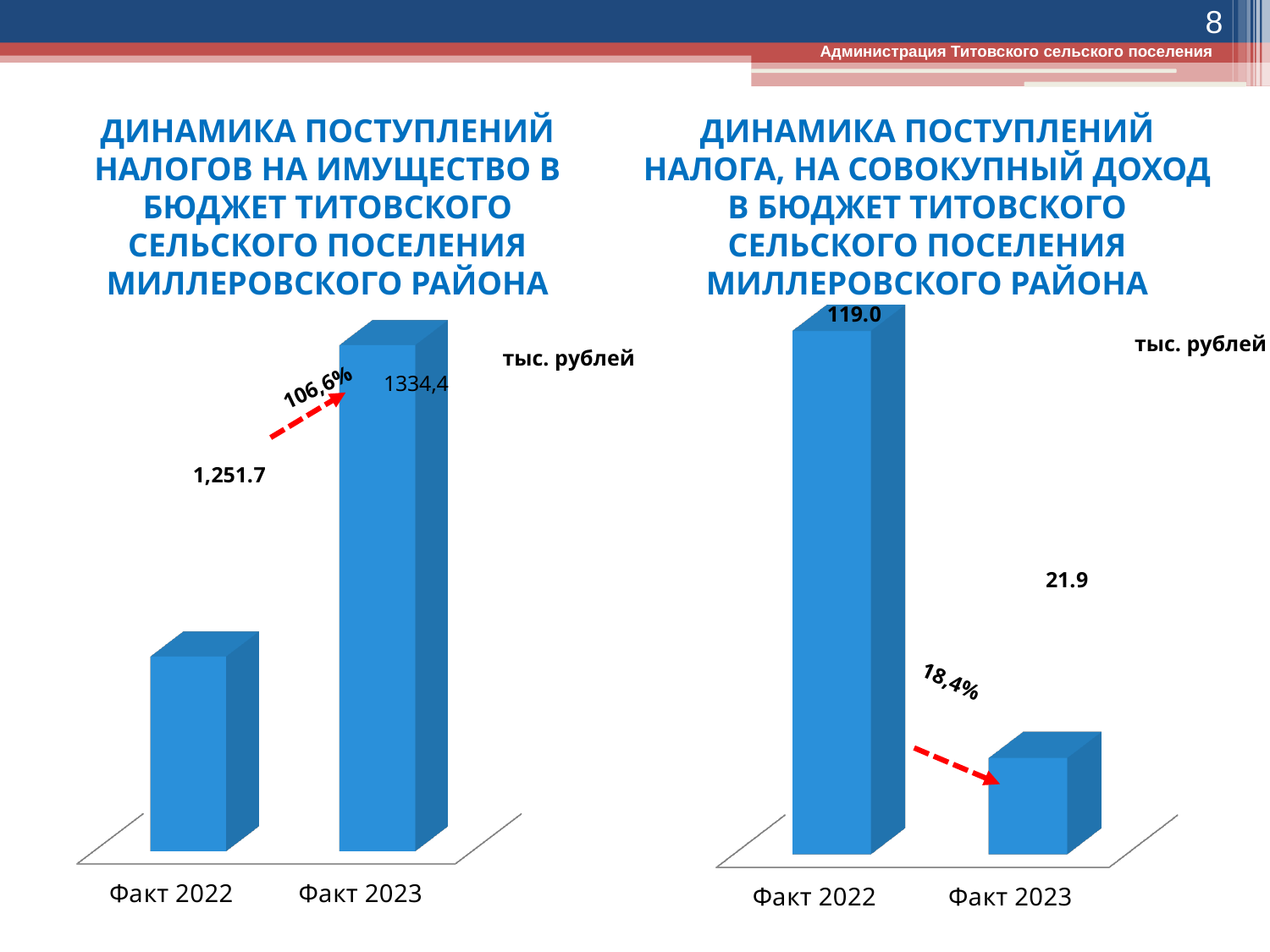
What percentage is written next to the arrow on the left chart? 106,6% On the right chart, what is the difference between the values for Факт 2022 and Факт 2023? 97.1 On the right chart, which category has the highest value? Факт 2022 On the right chart, what is the value for Факт 2023? 21.9 What kind of chart is the right chart? Bar chart On the right chart, what is the value for Факт 2022? 119.0 On the left chart, what is the value for Факт 2022? 1,251.7 How many categories are shown on the left chart? 2 On the right chart, which is larger, the value for Факт 2022 or Факт 2023? Факт 2022 On the left chart, what is the value for Факт 2023? 1334,4 On the right chart, which category has the lowest value? Факт 2023 On the right chart, do the values rise or fall from Факт 2022 to Факт 2023? Fall